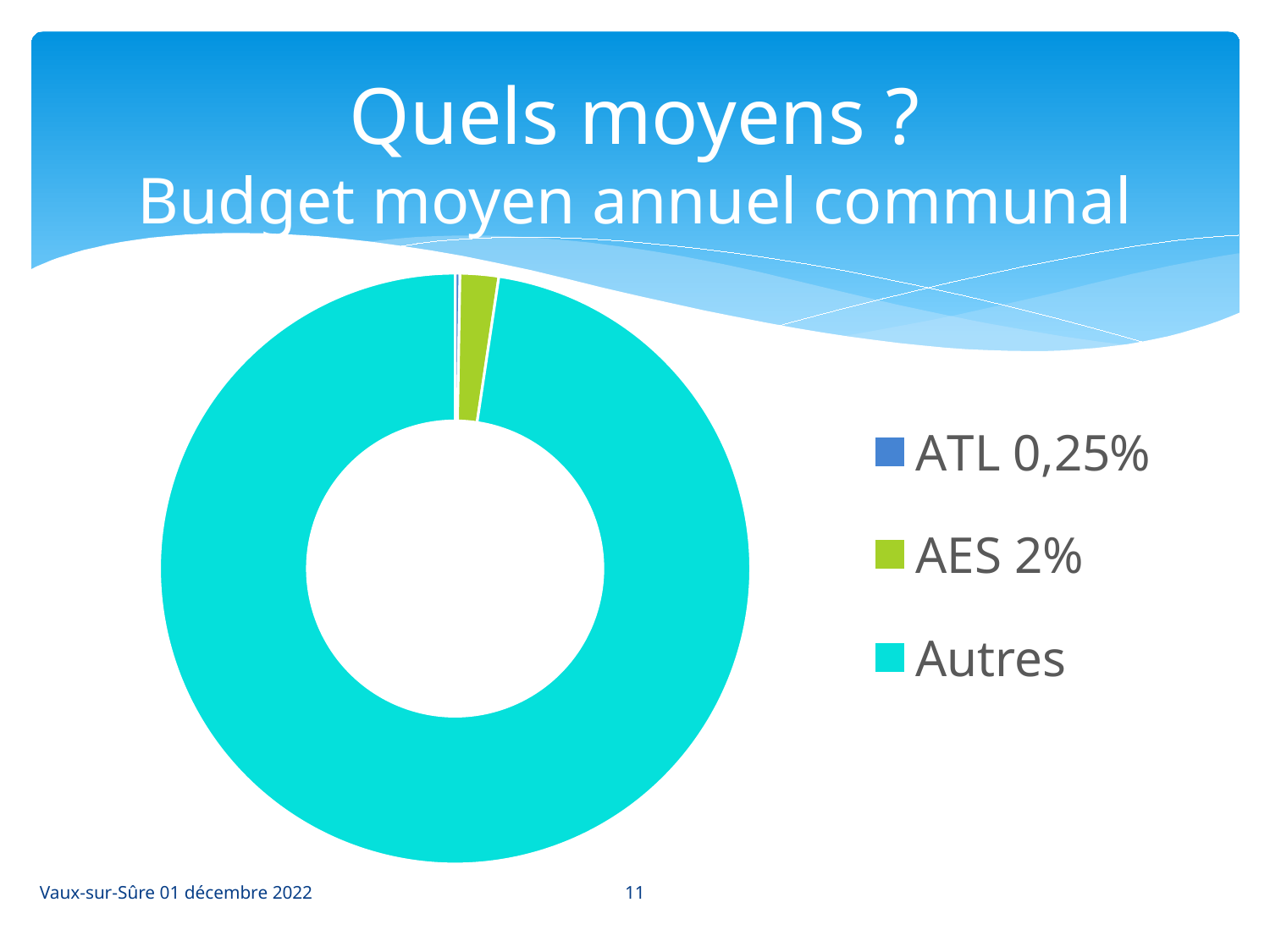
What percentage is shown for ATL in the legend? 0,25% Which is larger, the share for AES or the share for ATL? AES Which category takes up the largest part of the chart? Autres Is the share for Autres greater or less than 50%? greater How many categories does the chart show? 3 Which category takes up the smallest part of the chart? ATL What kind of chart is shown on the slide? doughnut chart What colour is the Autres segment of the chart? turquoise What percentage is shown for AES in the legend? 2% What is the difference between the AES share and the ATL share? 1,75% What is the subtitle of the slide describing the chart? Budget moyen annuel communal